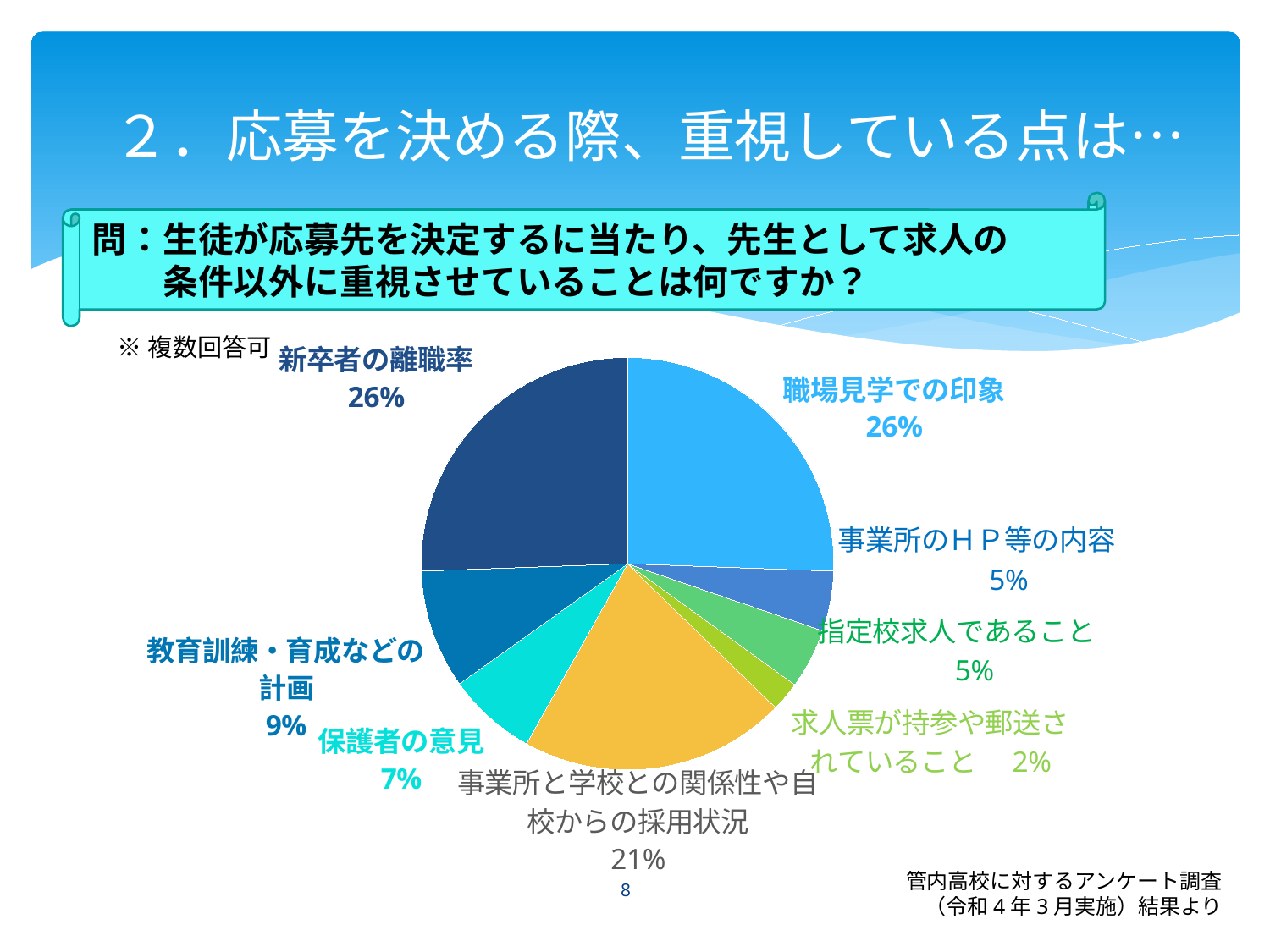
What is the difference in percentage points between 新卒者の離職率 and 事業所と学校との関係性や自校からの採用状況? 5 Which is larger, the share for 教育訓練・育成などの計画 or the share for 保護者の意見? 教育訓練・育成などの計画 How many slices does the pie chart have? 8 What percentage is shown for 指定校求人であること? 5% What percentage is shown for 教育訓練・育成などの計画? 9% Which category has the smallest share of the pie? 求人票が持参や郵送されていること What kind of chart is shown on the slide? pie chart What percentage is shown for 保護者の意見? 7% What is the combined share of 事業所のＨＰ等の内容 and 指定校求人であること? 10% What is the difference in percentage points between 職場見学での印象 and 事業所のＨＰ等の内容? 21 What percentage is shown for 職場見学での印象? 26% What percentage is shown for 事業所と学校との関係性や自校からの採用状況? 21%